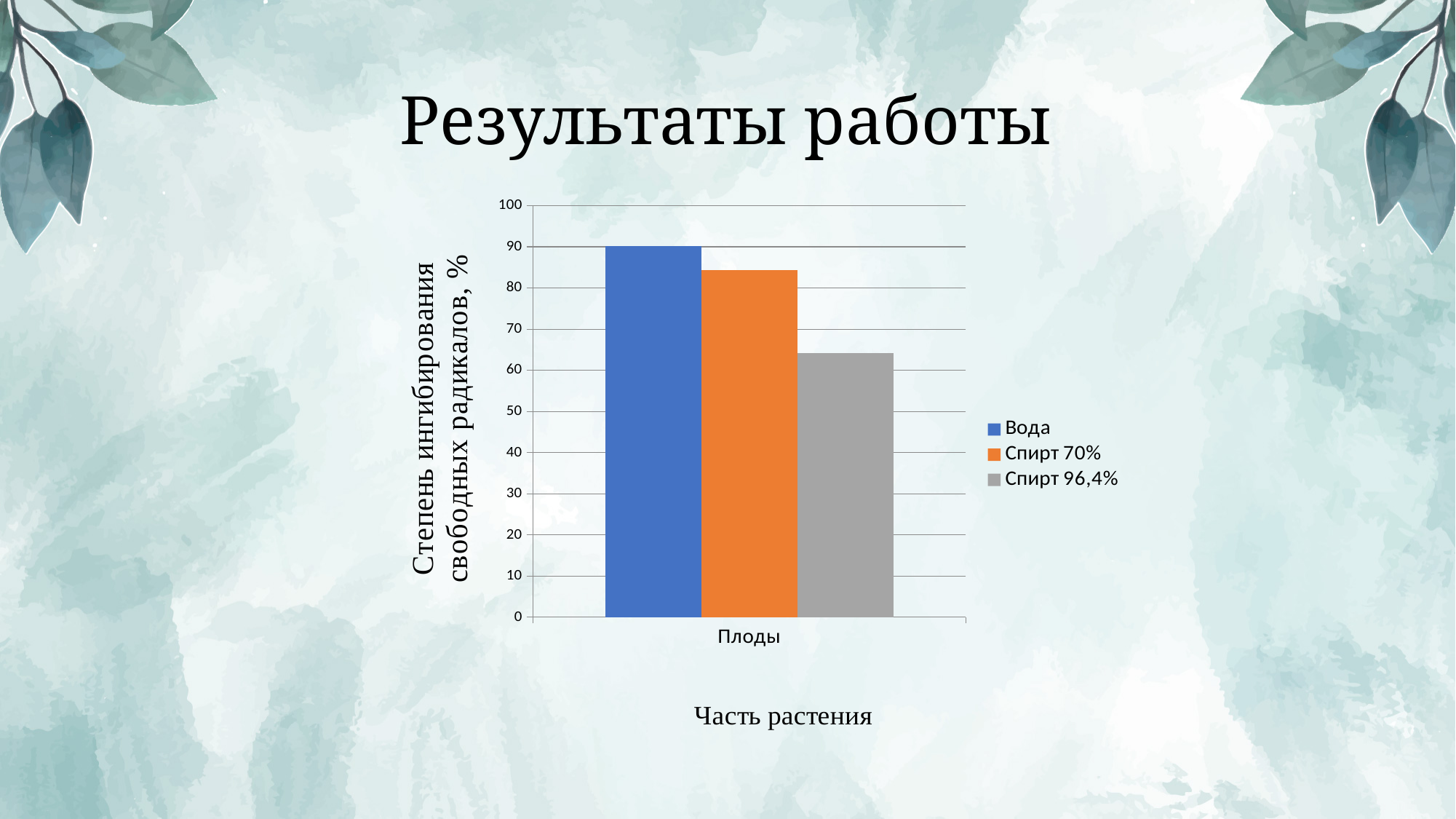
What kind of chart is shown on the slide? bar chart Which series has the highest value for Плоды? Вода How many categories are shown on the x axis? 1 What is the label of the x axis? Часть растения What is the title of the slide? Результаты работы Is the value for Спирт 96,4% greater or less than 60? greater How many series does the legend list? 3 Which series has the lowest value for Плоды? Спирт 96,4% Is the value for Спирт 70% greater or less than 80? greater Is the value for Спирт 96,4% greater or less than 70? less Which is larger for Плоды: Спирт 70% or Спирт 96,4%? Спирт 70%